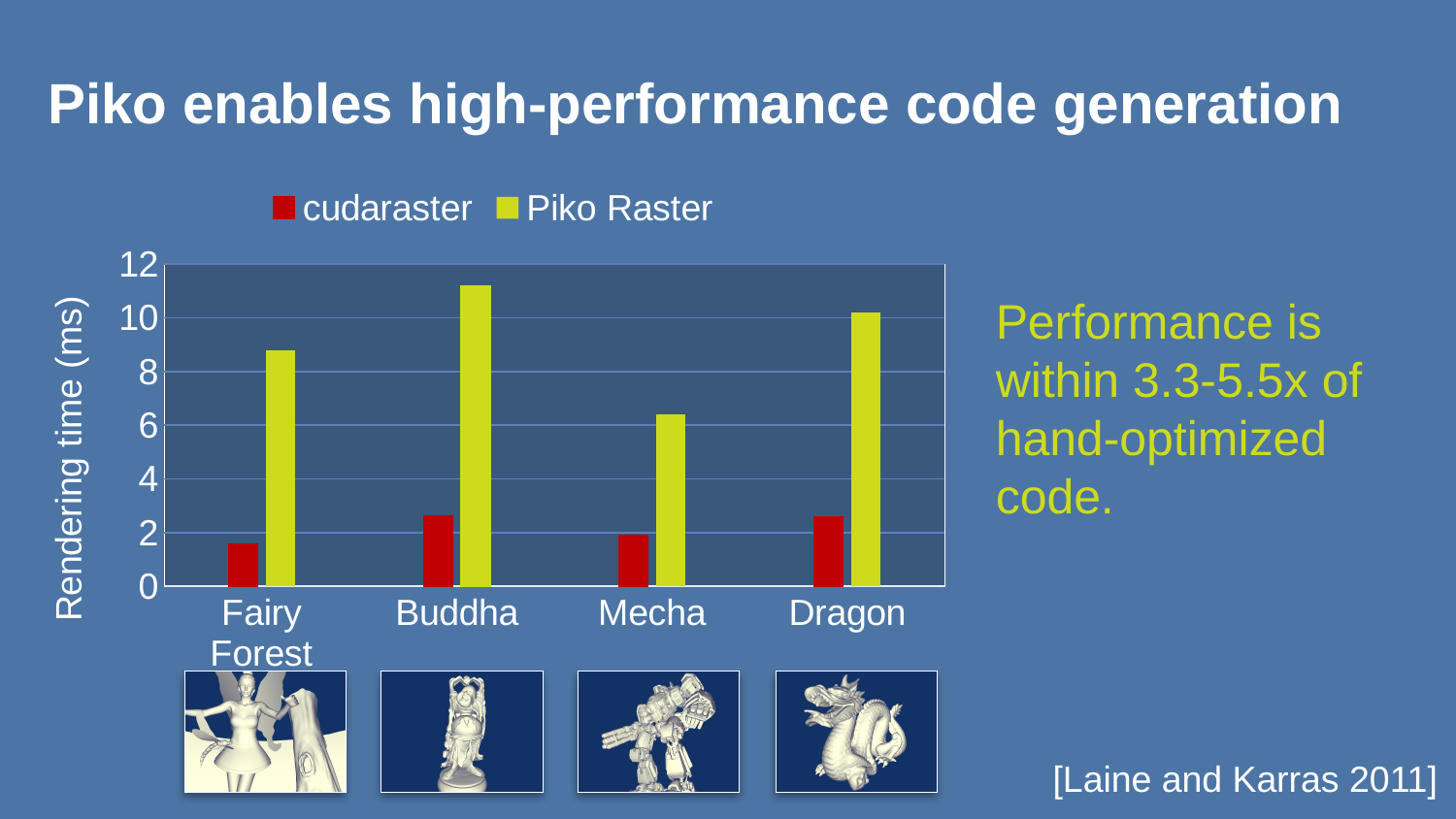
Is the cudaraster rendering time for Fairy Forest greater or less than 2? less What kind of chart is shown on the slide? bar chart Is the Piko Raster rendering time for Fairy Forest greater or less than 8? greater Which is larger, the Piko Raster rendering time for Fairy Forest or for Dragon? Dragon How many series does the legend list? 2 Is the Piko Raster rendering time for Mecha greater or less than 8? less Which category has the lowest Piko Raster rendering time? Mecha Which category has the highest Piko Raster rendering time? Buddha Which series has the larger rendering time for Mecha, cudaraster or Piko Raster? Piko Raster What is the label of the y axis? Rendering time (ms) How many categories are shown on the x axis? 4